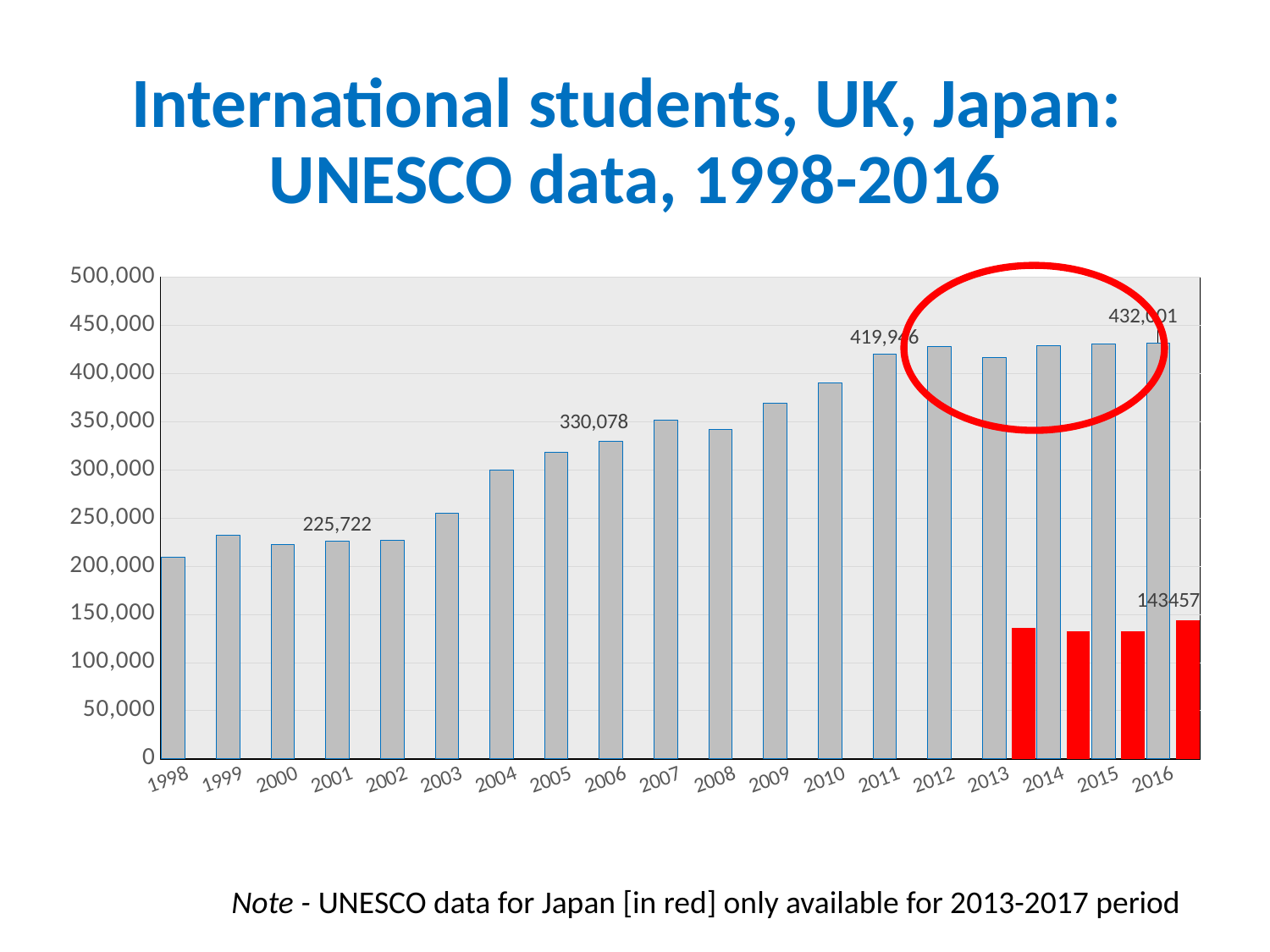
How many years are shown on the x axis? 19 Which year has the highest Japan (red) value? 2016 What type of chart is shown on the slide? bar chart What is the value of the UK bar for 2006? 330,078 Is the UK value for 1998 greater or less than 200,000? greater What is the value of the Japan (red) bar for 2016? 143457 What is the value of the UK bar for 2001? 225,722 Which is larger, the UK value for 2006 or for 2001? 2006 What is the difference between the UK values for 2006 and 2001? 104,356 Which year has the lowest UK value? 1998 Is the UK value for 2010 greater or less than 400,000? less Is the Japan value for 2013 greater or less than 150,000? less